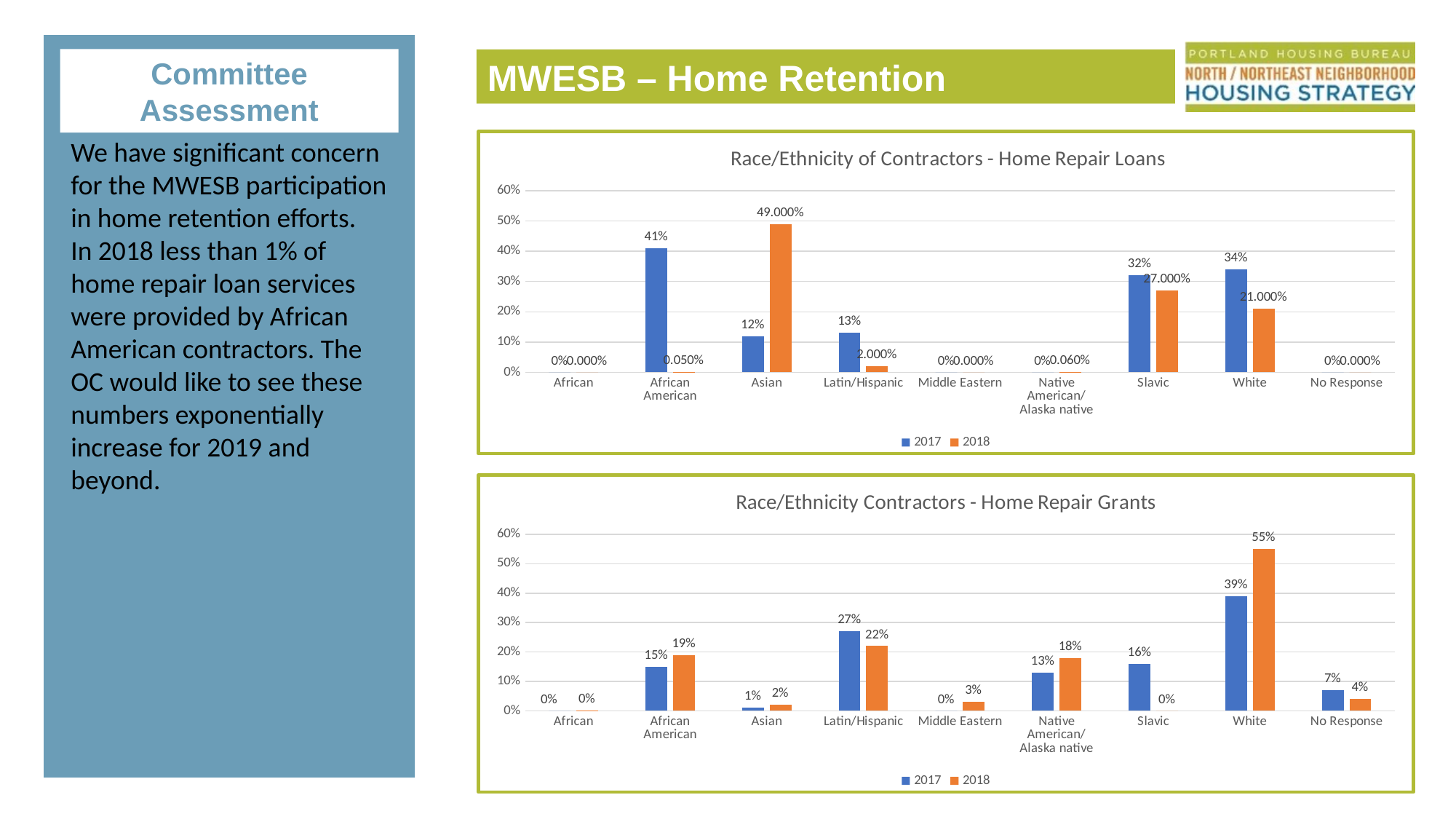
In the Home Repair Grants chart, which category has the highest 2018 value? White What type of chart is the Home Repair Grants chart? Bar chart How many series does the legend of the Home Repair Loans chart list? 2 In the Home Repair Loans chart, what is the difference between the 2017 and 2018 values for White? 13% In the Home Repair Grants chart, what is the difference between the 2017 and 2018 values for Latin/Hispanic? 5% In the Home Repair Loans chart, which category has the highest 2017 value? African American How many categories are shown on the x axis of the Home Repair Grants chart? 9 In the Home Repair Loans chart, what is the 2018 value for Asian? 49.000% In the Home Repair Loans chart, which is larger for Slavic: the 2017 value or the 2018 value? 2017 In the Home Repair Loans chart, what is the 2017 value for African American? 41% In the Home Repair Grants chart, is the 2017 value for White greater or less than 30%? greater In the Home Repair Grants chart, what is the 2018 value for White? 55%